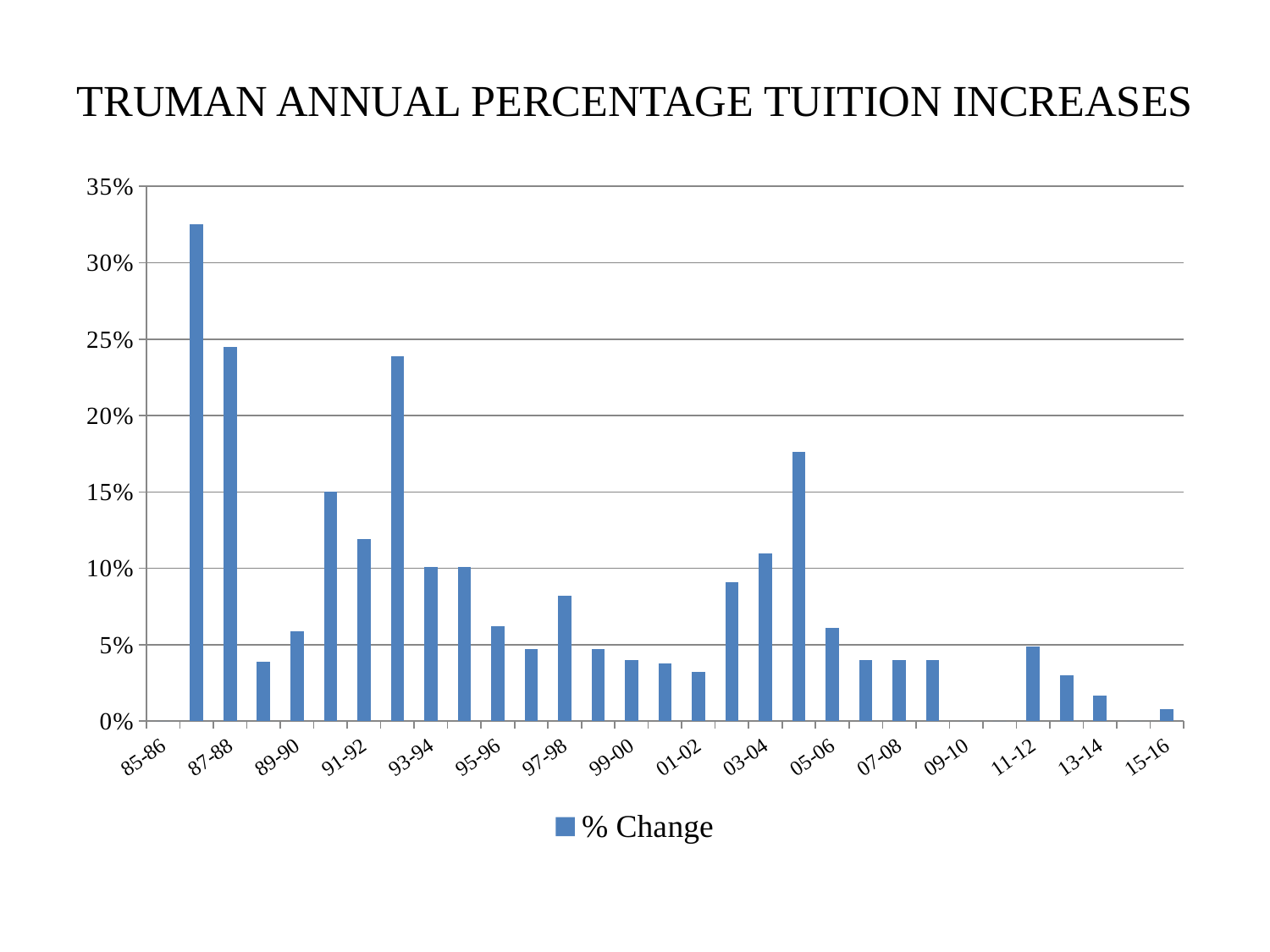
What kind of chart is shown on the slide? bar chart What is the title of the chart? TRUMAN ANNUAL PERCENTAGE TUITION INCREASES How many series does the legend list? 1 What is the legend entry for the series? % Change Is the value for 87-88 greater or less than 20%? greater Is the value for 13-14 greater or less than 5%? less Which has the larger value, 87-88 or 91-92? 87-88 How many year labels are shown on the x axis? 16 Is the value for 03-04 greater or less than 10%? greater Do the values generally rise or fall from left to right along the x axis? fall